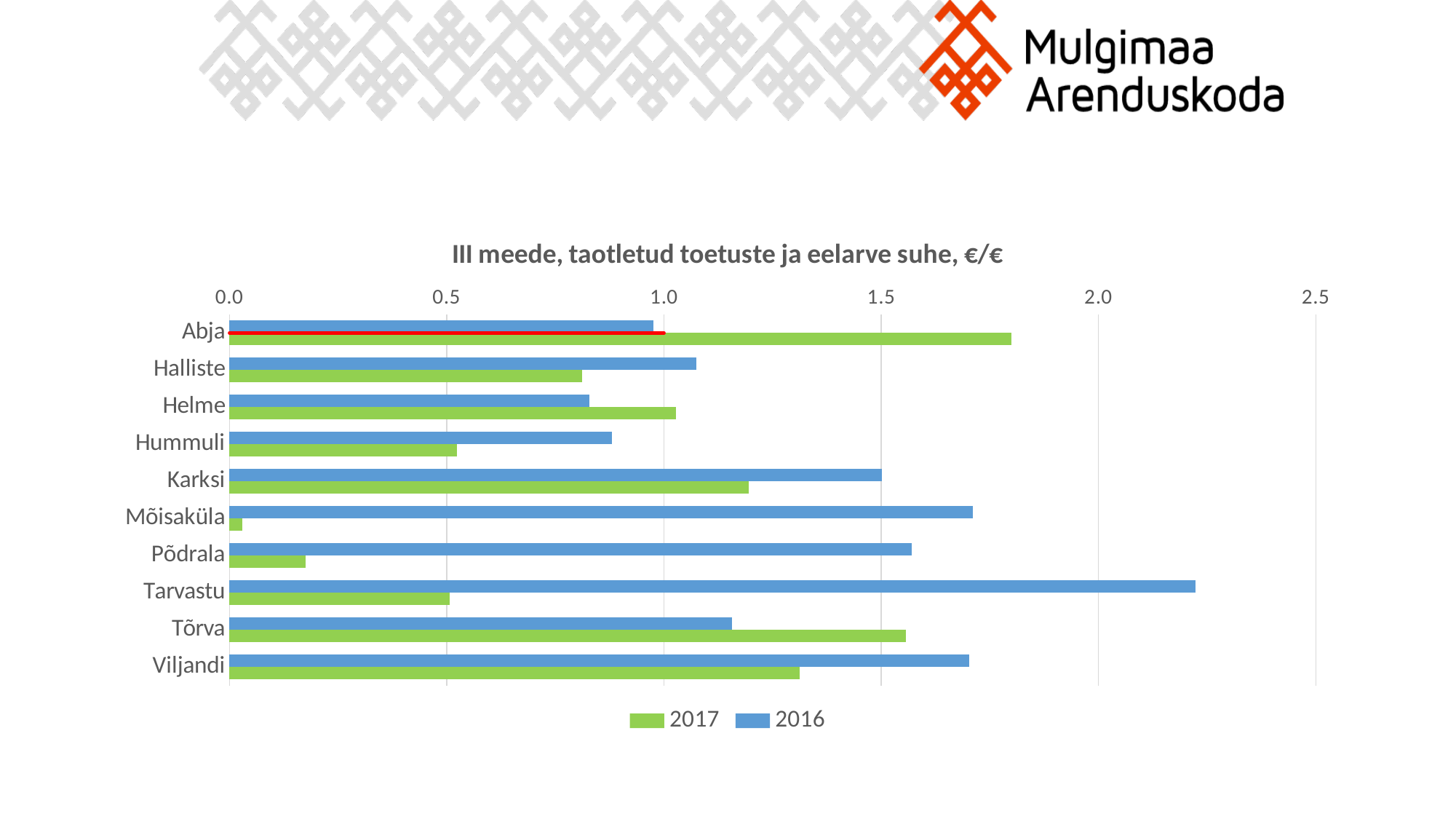
Which category has the lowest value for 2017? Mõisaküla Is the 2017 value for Abja greater or less than 1.5? greater Which category has the highest value for 2017? Abja Is the 2016 value for Tarvastu greater or less than 2.0? greater How many categories (municipalities) are listed on the chart? 10 What kind of chart is shown on the slide? bar chart What is the title of the chart? III meede, taotletud toetuste ja eelarve suhe, €/€ Is the 2017 value for Mõisaküla greater or less than 0.5? less For Abja, which year has the larger value, 2016 or 2017? 2017 Which category has the highest value for 2016? Tarvastu How many series does the legend list? 2